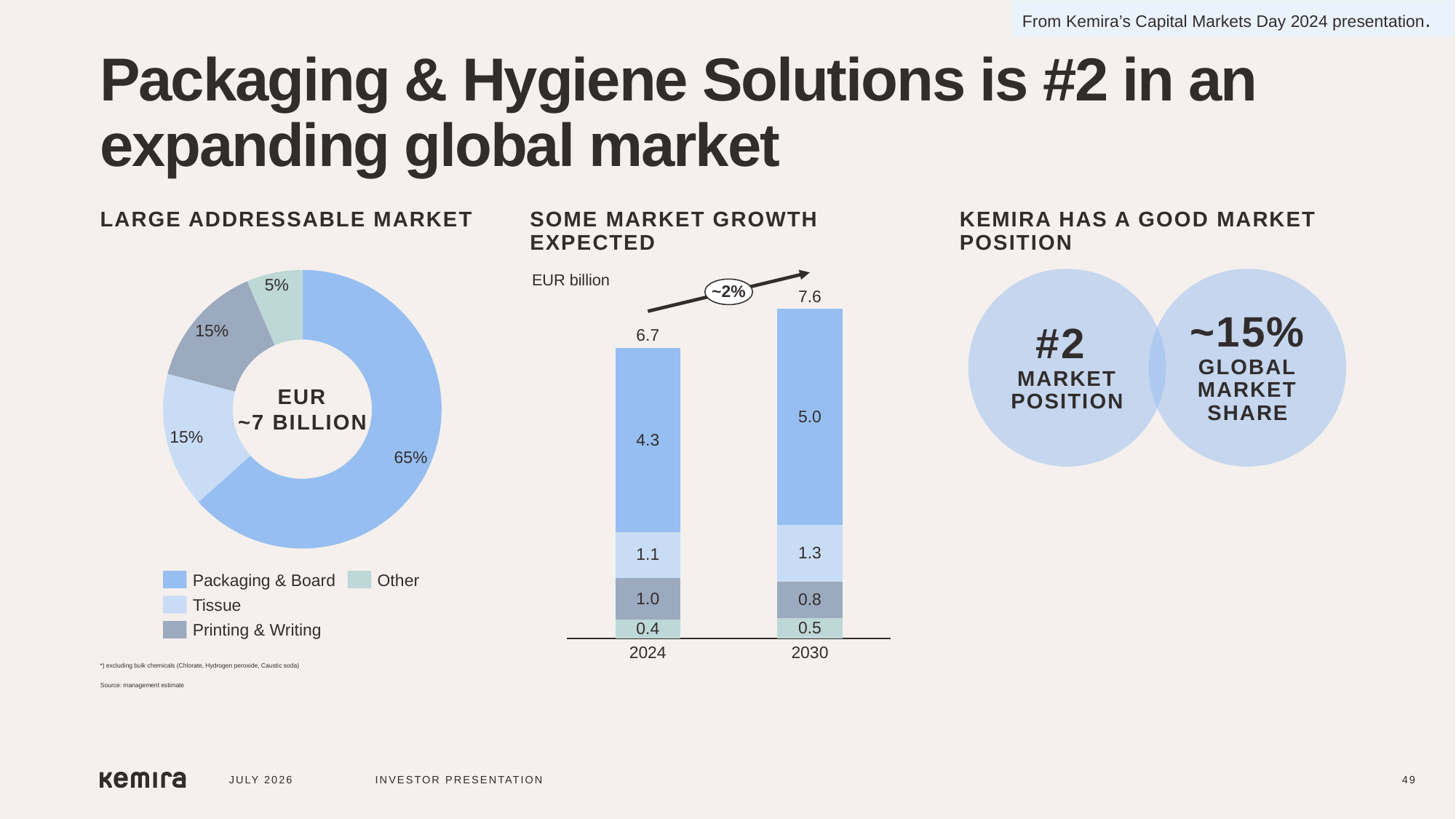
In the 'Large addressable market' donut chart, which segment is the smallest? Other What type of chart is used under 'Large addressable market'? Donut (pie) chart In the 'Some market growth expected' bar chart, is the Tissue value larger in 2024 or 2030? 2030 How many segments does the 'Large addressable market' donut chart have? 4 In the 'Some market growth expected' bar chart, what is the Packaging & Board value for 2030? 5.0 In the 'Large addressable market' donut chart, what share does Packaging & Board hold? 65% In the 'Large addressable market' donut chart, which segment is the largest? Packaging & Board In the 'Some market growth expected' bar chart, what is the difference between the 2030 and 2024 totals? 0.9 In the 'Some market growth expected' bar chart, what is the total for 2030? 7.6 In the 'Large addressable market' donut chart, what share does Other hold? 5% What unit is shown for the 'Some market growth expected' bar chart? EUR billion In the 'Some market growth expected' bar chart, what is the total for 2024? 6.7